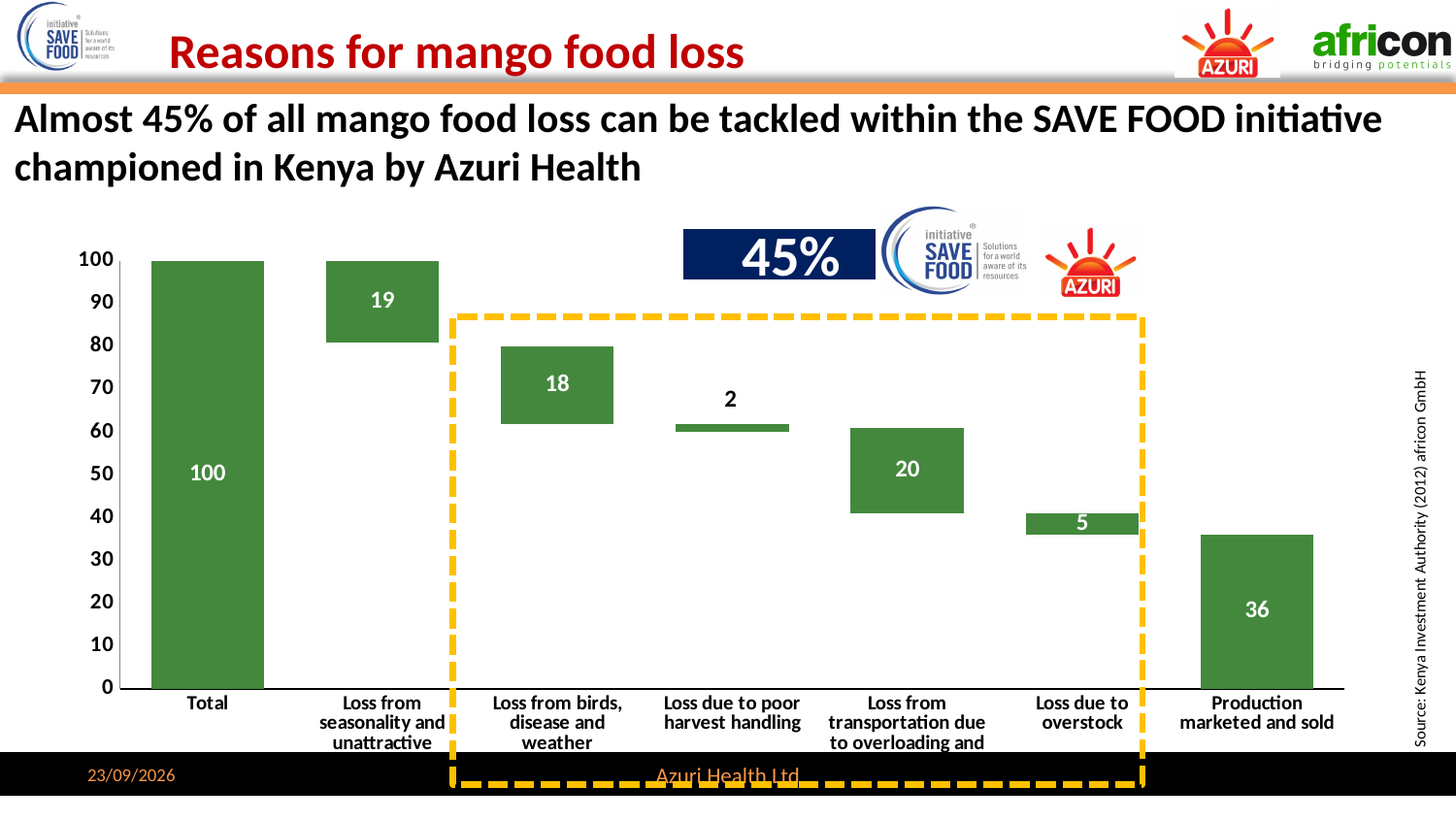
What value is shown for Production marketed and sold? 36 What percentage is shown in the blue box above the dashed yellow outline? 45% What value is shown for Loss from birds, disease and weather? 18 How many categories are shown on the x axis of the chart? 7 Which is larger: the value for Loss from seasonality and unattractive or the value for Loss from birds, disease and weather? Loss from seasonality and unattractive What is the difference between the value for Loss from transportation due to overloading and the value for Loss due to overstock? 15 What kind of chart is shown on the slide? Bar chart (waterfall) What value is shown for Loss due to poor harvest handling? 2 What value is shown for Loss due to overstock? 5 Among the loss categories (excluding Total and Production marketed and sold), which has the largest value? Loss from transportation due to overloading and What value is shown for the Total bar? 100 Which category has the smallest value on the chart? Loss due to poor harvest handling